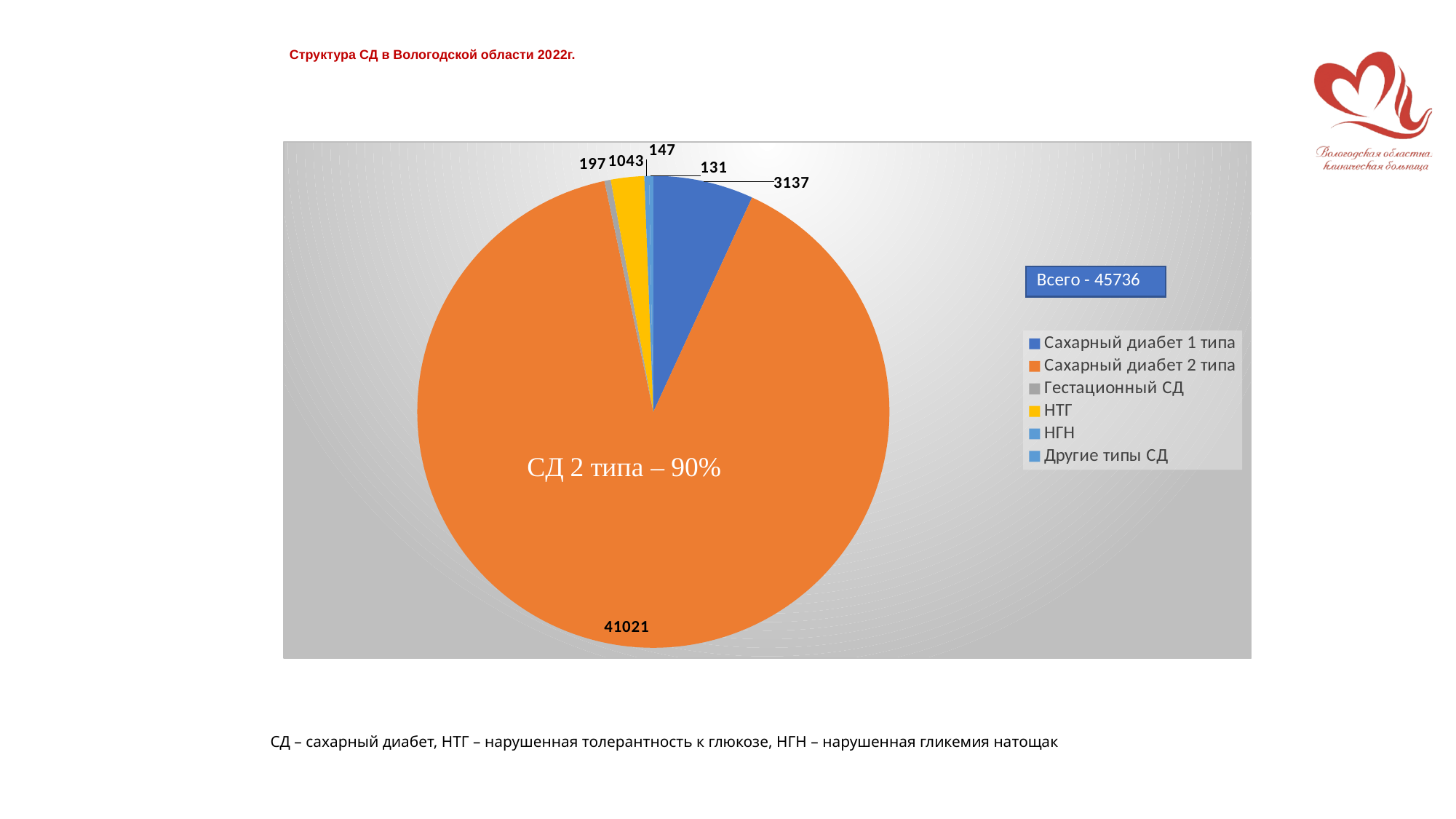
What share of the pie does СД 2 типа account for, as printed on the chart? 90% What is the value for Сахарный диабет 1 типа? 3137 What is the value for НТГ? 1043 What is the value for Гестационный СД? 197 What total (Всего) is shown next to the chart? 45736 What kind of chart is shown on the slide? pie chart Which is larger, the value for НТГ or the value for Гестационный СД? НТГ What is the difference between the values for Сахарный диабет 2 типа and Сахарный диабет 1 типа? 37884 What is the difference between the values for Сахарный диабет 1 типа and Гестационный СД? 2940 What is the value for Сахарный диабет 2 типа? 41021 How many categories does the legend list? 6 Which category has the largest slice of the pie? Сахарный диабет 2 типа